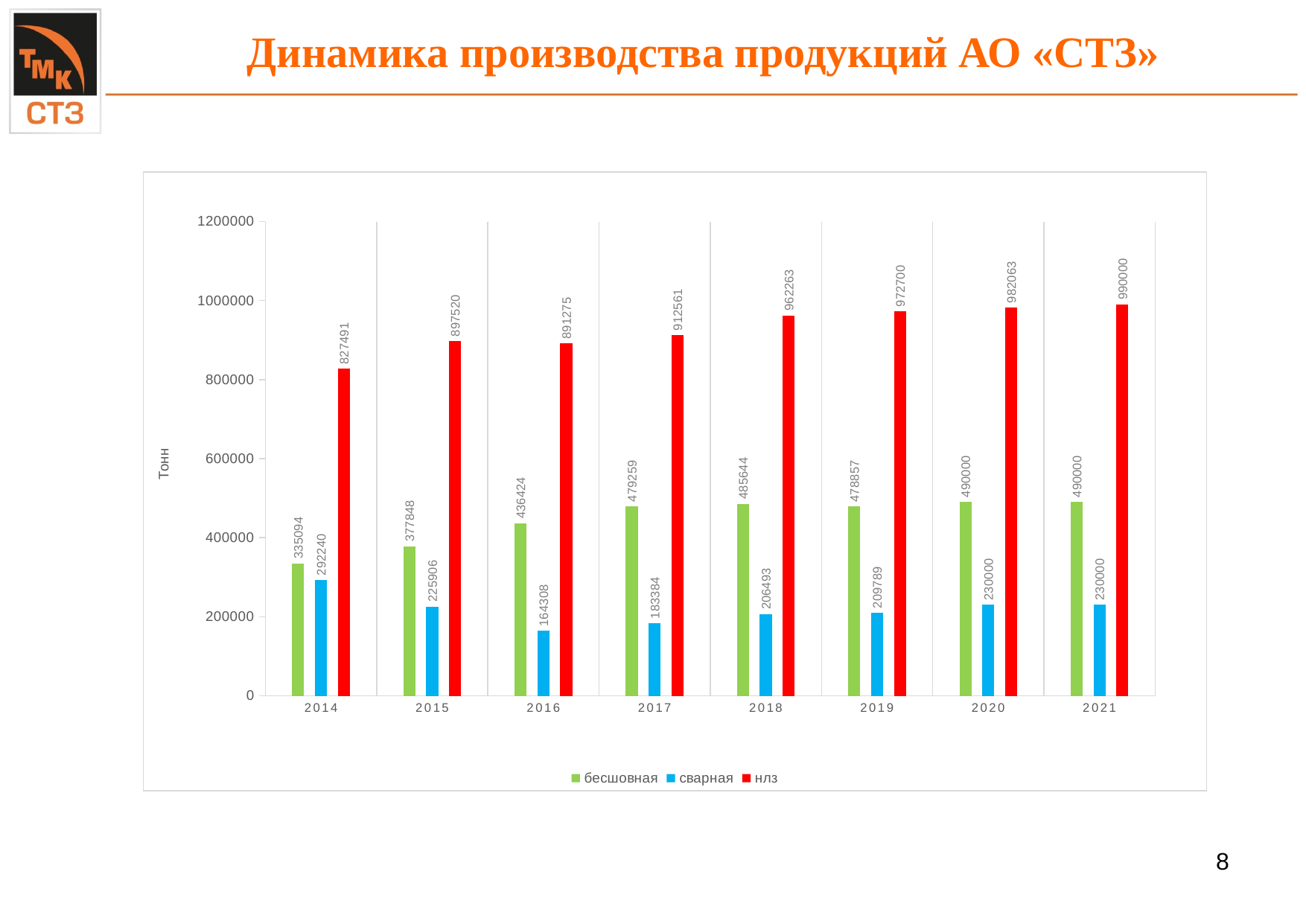
What kind of chart is shown on the slide? bar chart What is the value for нлз in 2014? 827491 In which year is the сварная value lowest? 2016 Does the нлз value rise or fall from 2014 to 2021? rise What is the value for сварная in 2016? 164308 How many years are shown on the x axis? 8 What is the difference between бесшовная and сварная in 2020? 260000 What is the difference between the нлз value in 2021 and in 2014? 162509 In which year is the нлз value highest? 2021 What is the value for бесшовная in 2017? 479259 How many series does the legend list? 3 Which is larger, the бесшовная value in 2018 or in 2019? 2018